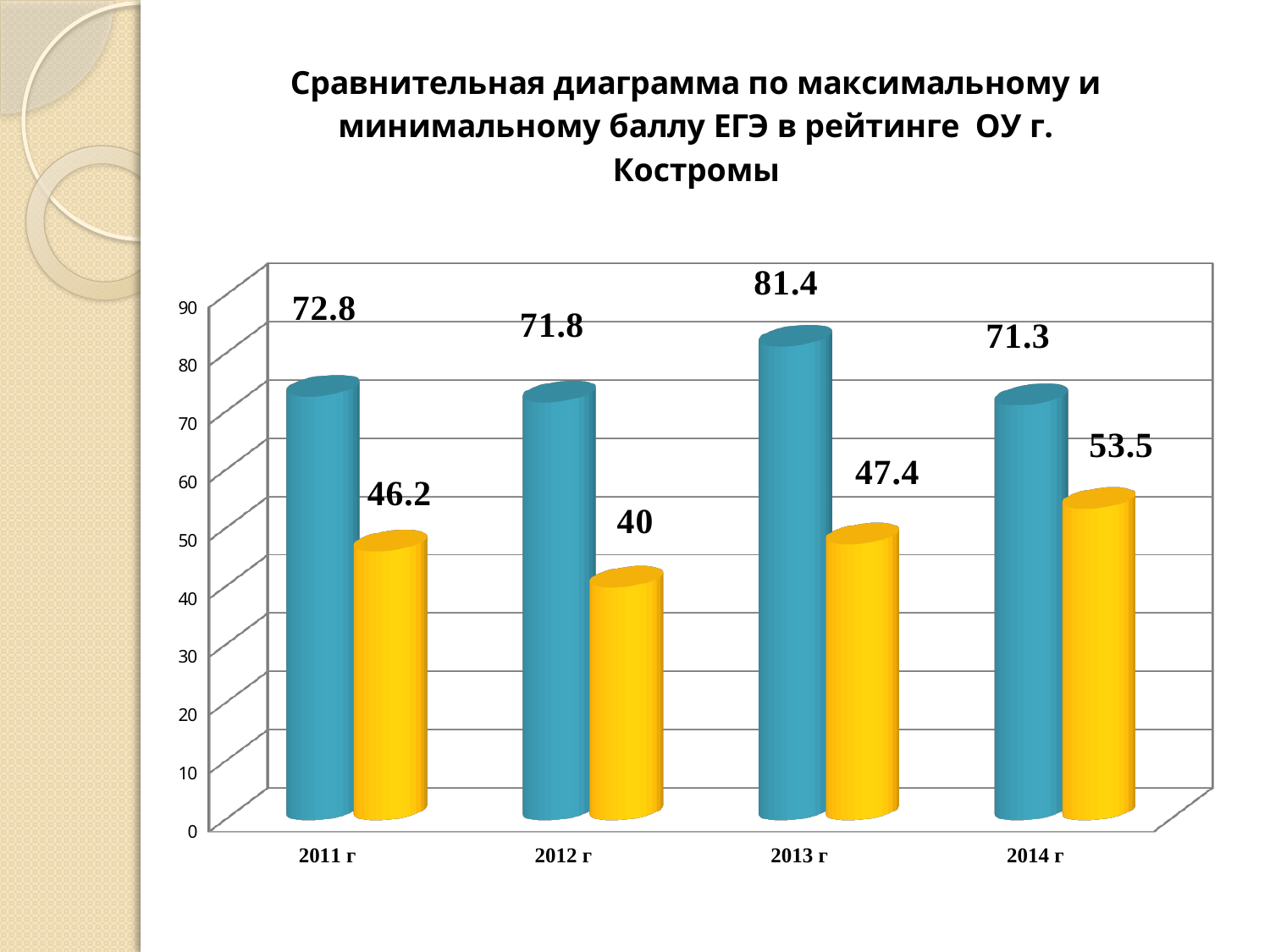
In which year is the blue bar the highest? 2013 г How many years are shown on the x axis? 4 In which year is the yellow bar the highest? 2014 г Which is larger: the yellow bar for 2011 г or the yellow bar for 2014 г? 2014 г What is the value of the blue bar for 2011 г? 72.8 In which year is the yellow bar the lowest? 2012 г What is the value of the blue bar for 2013 г? 81.4 What type of chart is shown on the slide? Bar chart What is the value of the yellow bar for 2014 г? 53.5 What is the difference between the blue and yellow bars for 2013 г? 34 What is the difference between the blue and yellow bars for 2011 г? 26.6 What is the value of the yellow bar for 2012 г? 40